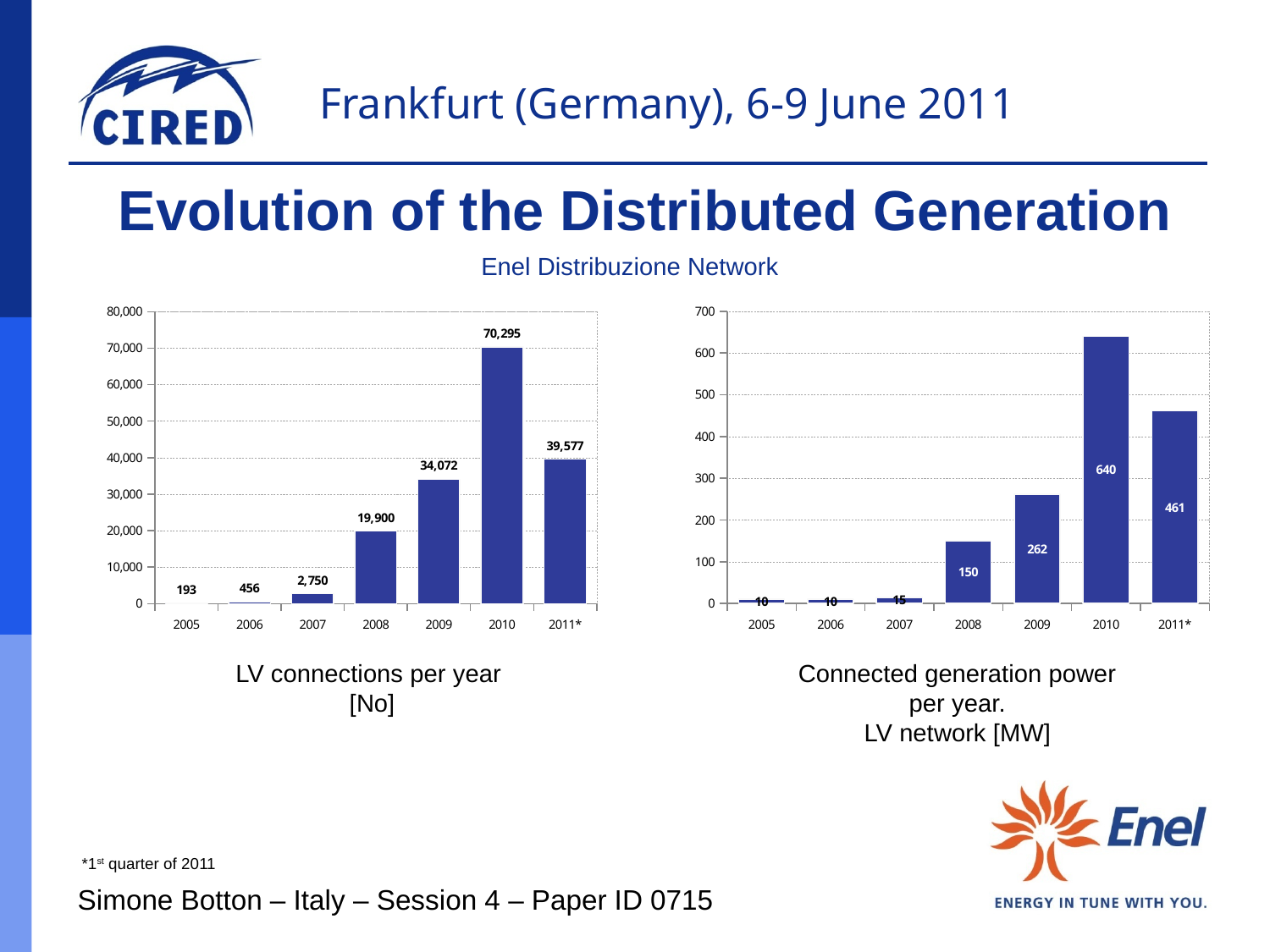
In the Connected generation power per year chart, which is larger, the value for 2008 or the value for 2011*? 2011* How many years are shown on the x axis of the LV connections per year chart? 7 In the Connected generation power per year chart, what is the value for 2009? 262 In the Connected generation power per year chart, which year has the highest value? 2010 What type of chart is the Connected generation power per year chart? Bar chart In the Connected generation power per year chart, what is the difference between the values for 2010 and 2009? 378 In the LV connections per year chart, which year has the highest value? 2010 In the LV connections per year chart, what is the difference between the values for 2010 and 2011*? 30,718 In the LV connections per year chart, what is the value for 2008? 19,900 In the LV connections per year chart, which year has the lowest value? 2005 In the Connected generation power per year chart, what is the value for 2011*? 461 In the LV connections per year chart, what is the value for 2010? 70,295